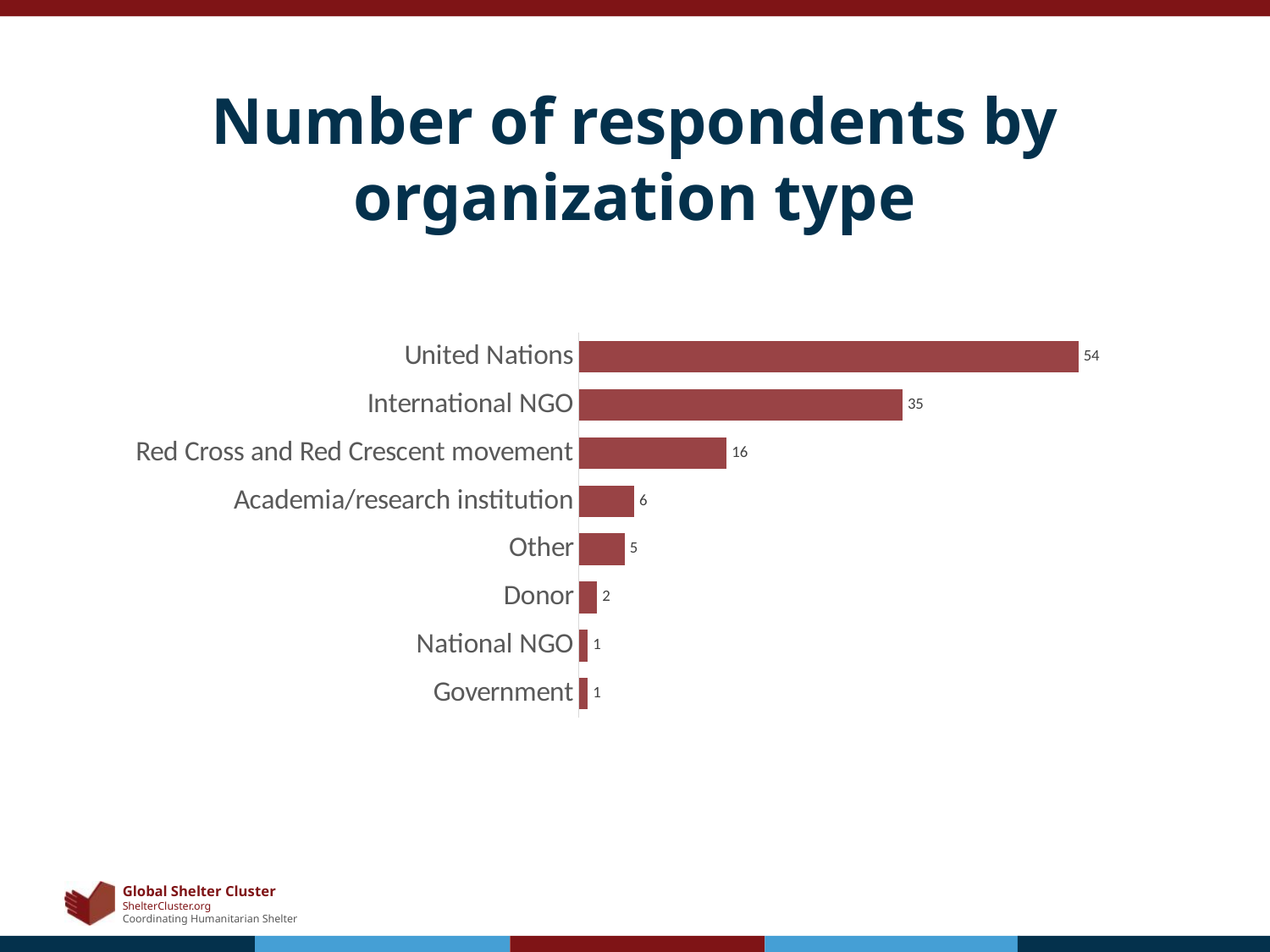
Which has more respondents, Academia/research institution or Other? Academia/research institution What kind of chart is shown on the slide? Bar chart How many respondents are from the United Nations? 54 What is the value for Academia/research institution? 6 What is the difference between the number of respondents from the United Nations and from International NGOs? 19 How many respondents are from Donor organizations? 2 What is the value for International NGO? 35 What is the difference between the values for Red Cross and Red Crescent movement and Donor? 14 How many organization types are shown in the chart? 8 How many respondents are from the Red Cross and Red Crescent movement? 16 Which organization type has the highest number of respondents? United Nations What is the title of the chart? Number of respondents by organization type